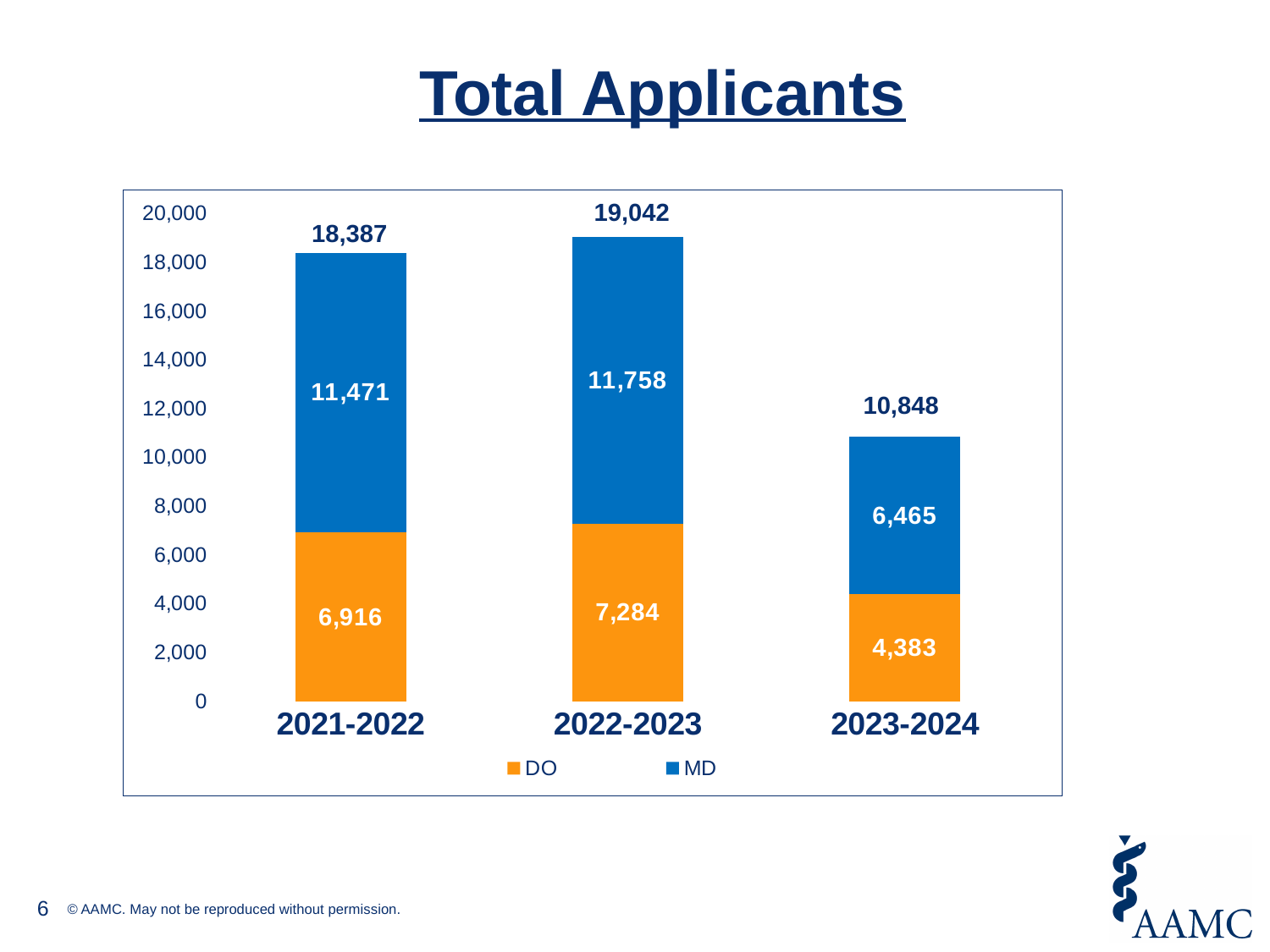
What is the title of the chart? Total Applicants What is the total of the stacked bar for 2023-2024? 10,848 What is the DO value for 2021-2022? 6,916 Which is larger, the DO value for 2022-2023 or the DO value for 2021-2022? 2022-2023 Is the total for 2023-2024 greater or less than 12,000? less What kind of chart is shown? stacked bar chart How many year categories are shown on the x axis? 3 Which year has the highest total applicants? 2022-2023 What is the MD value for 2022-2023? 11,758 Which year has the lowest DO value? 2023-2024 How many series does the legend list? 2 What is the difference between the MD values for 2022-2023 and 2021-2022? 287